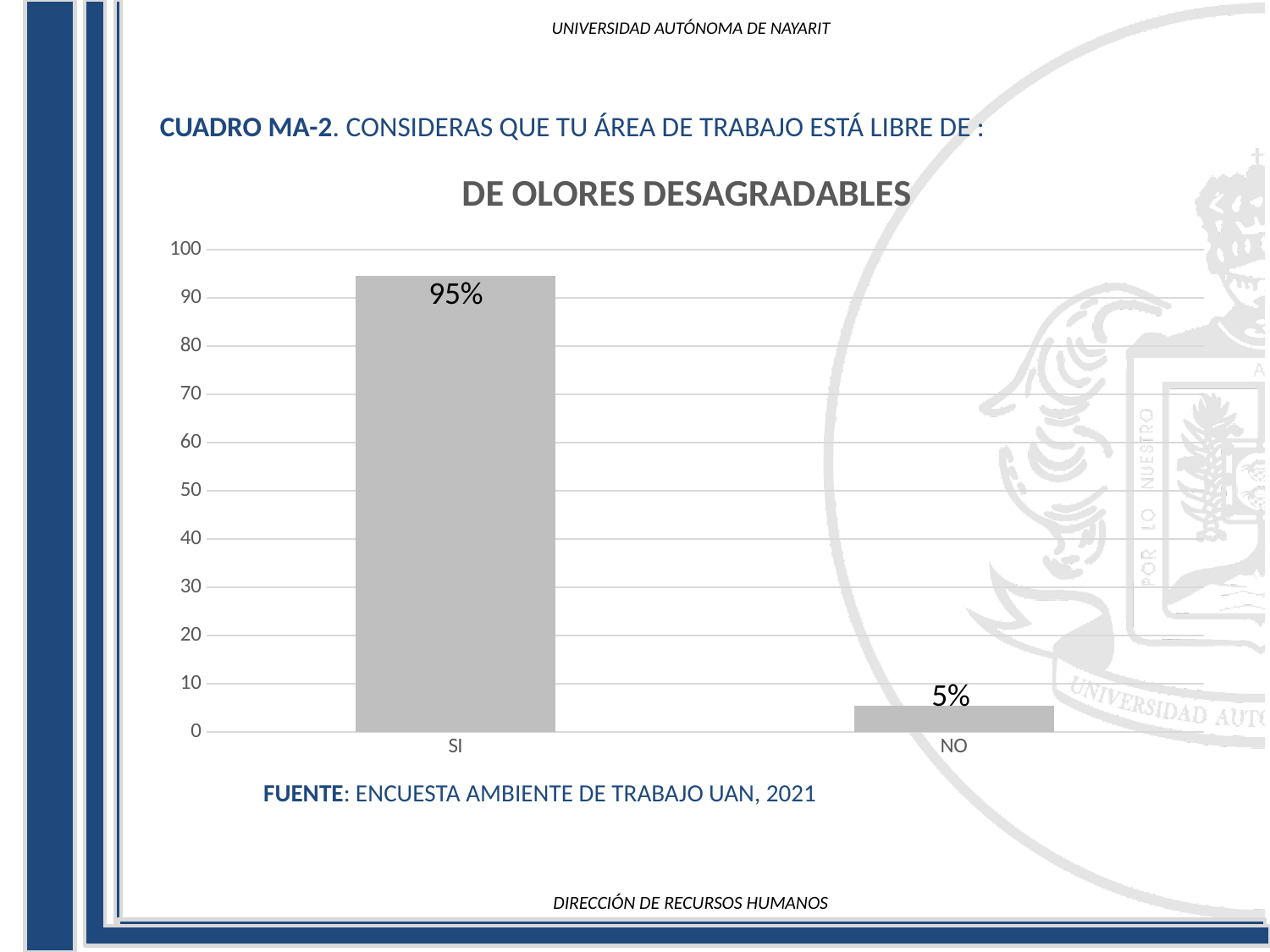
Is the value for SI greater or less than 90? greater What is the difference between the values for SI and NO? 90% What is the maximum value shown on the y axis? 100 What is the value for SI? 95% Is the value for NO greater or less than 10? less Which is larger, the value for SI or the value for NO? SI Which category has the lowest value? NO What is the title of the chart? DE OLORES DESAGRADABLES What kind of chart is shown on the slide? bar chart How many categories are shown on the x axis? 2 What is the value for NO? 5% Which category has the highest value? SI